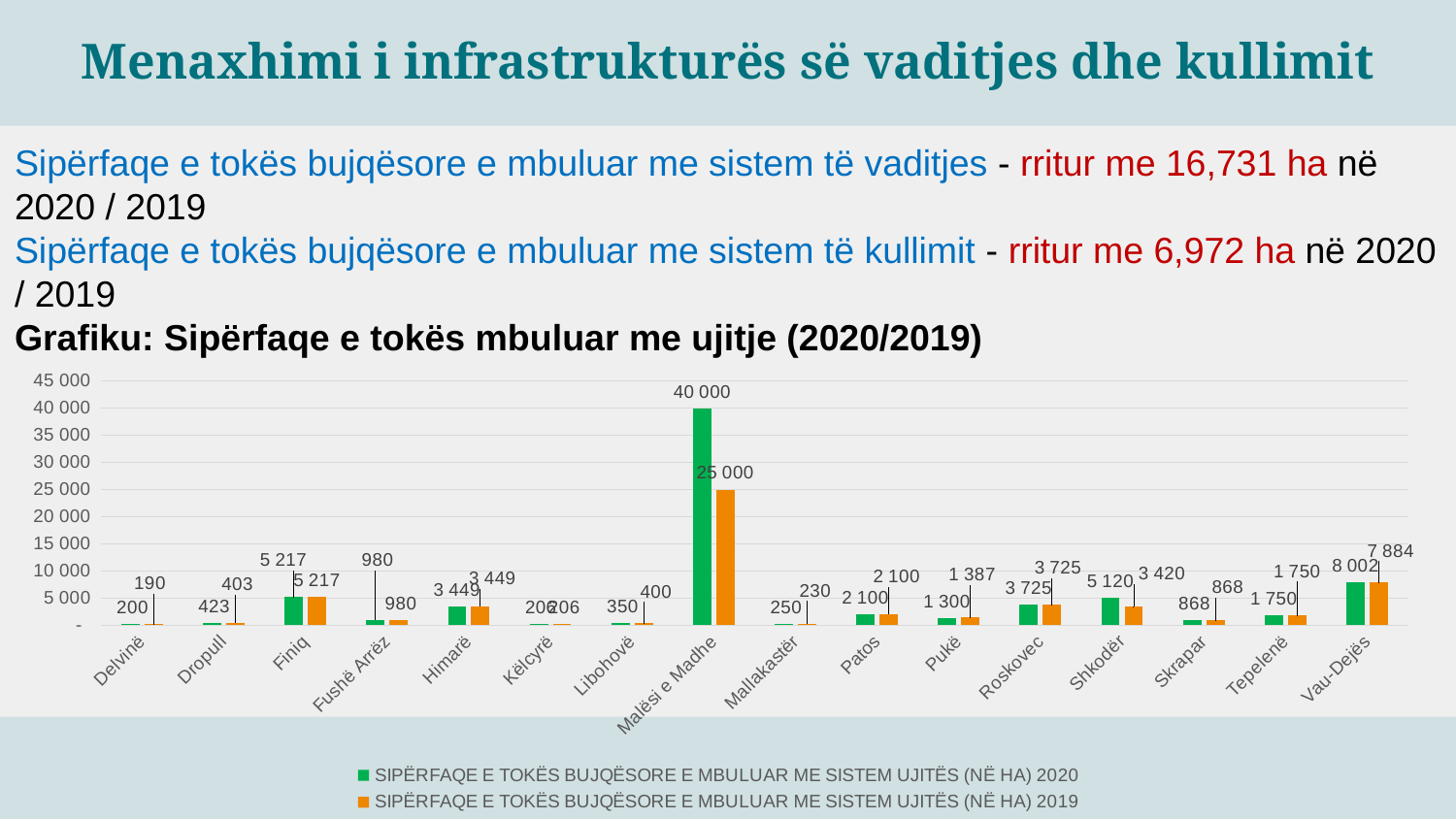
What is the value for Malësi e Madhe in the 2020 series? 40 000 How many municipalities are shown on the x axis of the chart? 16 What is the value for Malësi e Madhe in the 2019 series? 25 000 What is the value for Vau-Dejës in the 2020 series? 8 002 How many series does the legend list? 2 Which municipality has the highest value in the 2020 series? Malësi e Madhe Which colour represents the 2020 series in the chart? Green What is the difference between the 2020 and 2019 values for Malësi e Madhe? 15 000 What kind of chart is shown on the slide? Bar chart Is the 2020 value for Malësi e Madhe greater or less than 35 000? greater For Shkodër, which series has the larger value, 2020 or 2019? 2020 What is the difference between the 2020 and 2019 values for Shkodër? 1 700